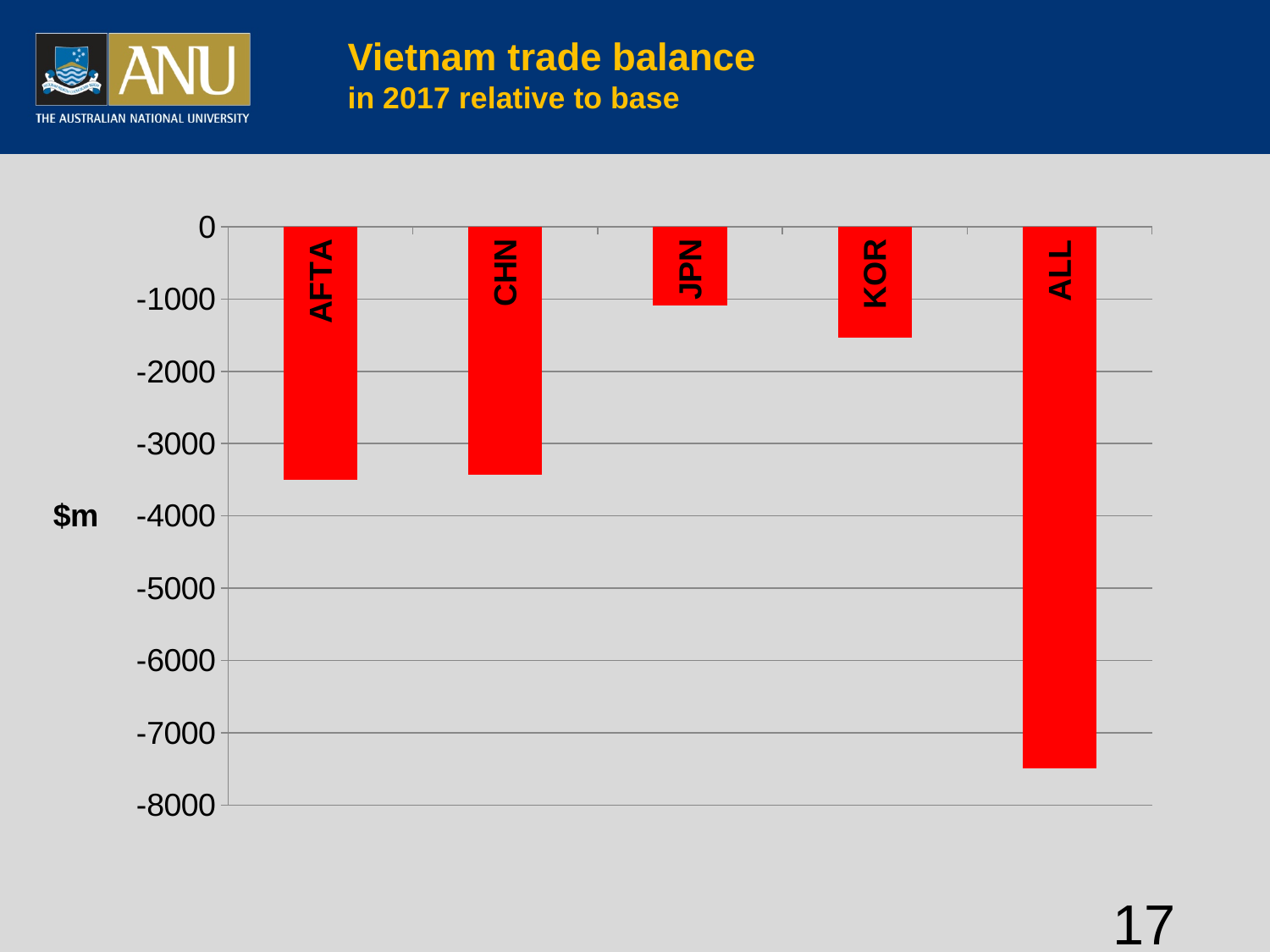
Is the value for KOR greater or less than -2000? greater Which category has the lowest (most negative) value? ALL What is the title of the chart? Vietnam trade balance in 2017 relative to base Is the value for ALL greater or less than -7000? less Which category has the highest value (closest to zero)? JPN How many categories are plotted in the chart? 5 Which has the lower value, ALL or AFTA? ALL What kind of chart is shown on the slide? bar chart Which has the lower value, KOR or JPN? KOR What unit is shown on the vertical axis label? $m Is the value for AFTA greater or less than -3000? less